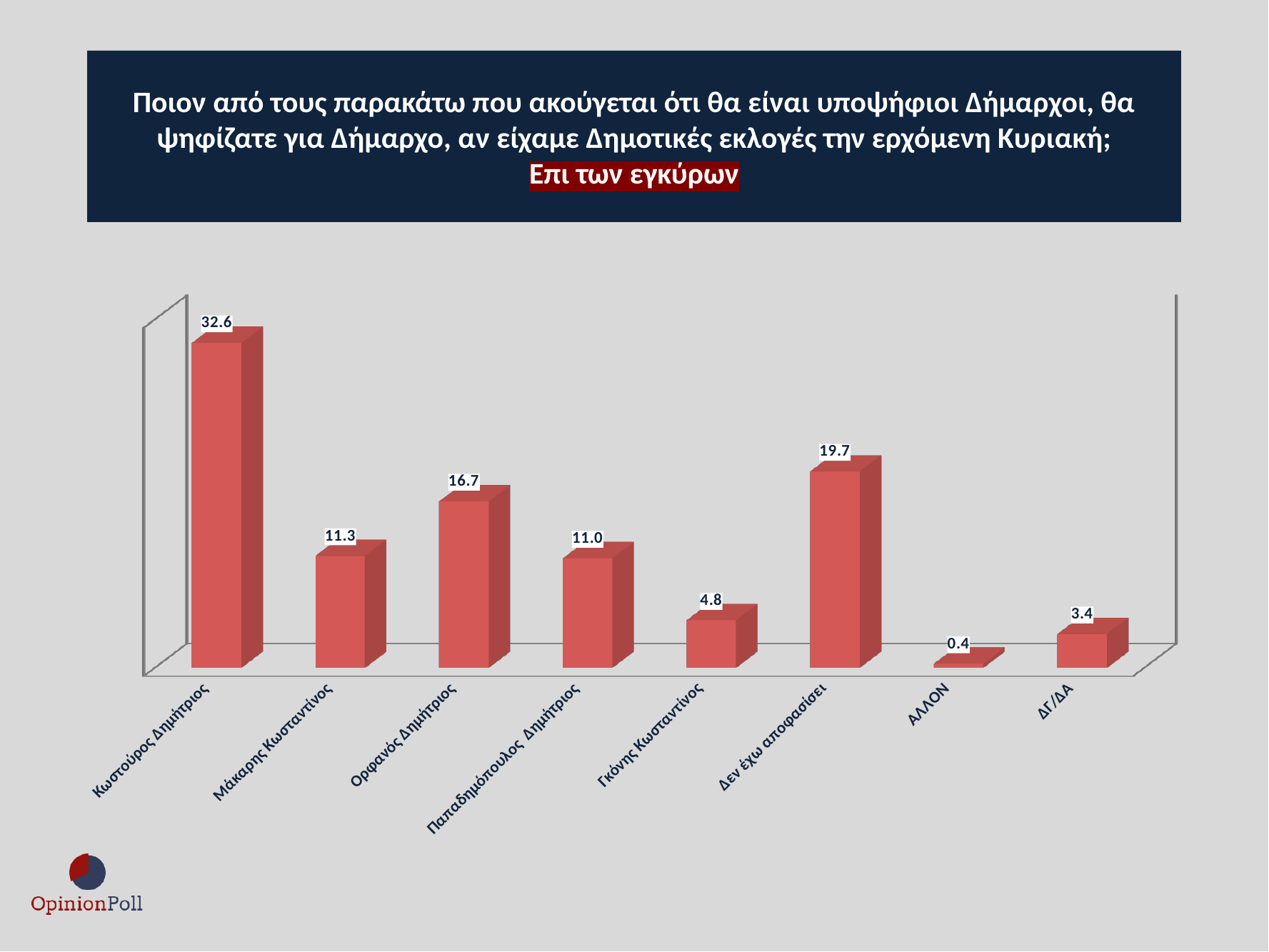
What is the value for Δεν έχω αποφασίσει? 19.7 What is the value for Κωστούρος Δημήτριος? 32.6 Which is larger, the value for Γκόνης Κωσταντίνος or the value for ΔΓ/ΔΑ? Γκόνης Κωσταντίνος Which category has the highest value? Κωστούρος Δημήτριος Which category has the lowest value? ΑΛΛΟΝ What is the value for ΔΓ/ΔΑ? 3.4 What is the value for Ορφανός Δημήτριος? 16.7 What colour are the bars in the chart? Red What is the difference between the values for Μάκαρης Κωσταντίνος and Παπαδημόπουλος Δημήτριος? 0.3 What is the difference between the values for Κωστούρος Δημήτριος and Ορφανός Δημήτριος? 15.9 How many categories are shown on the chart? 8 What kind of chart is shown on the slide? Bar chart